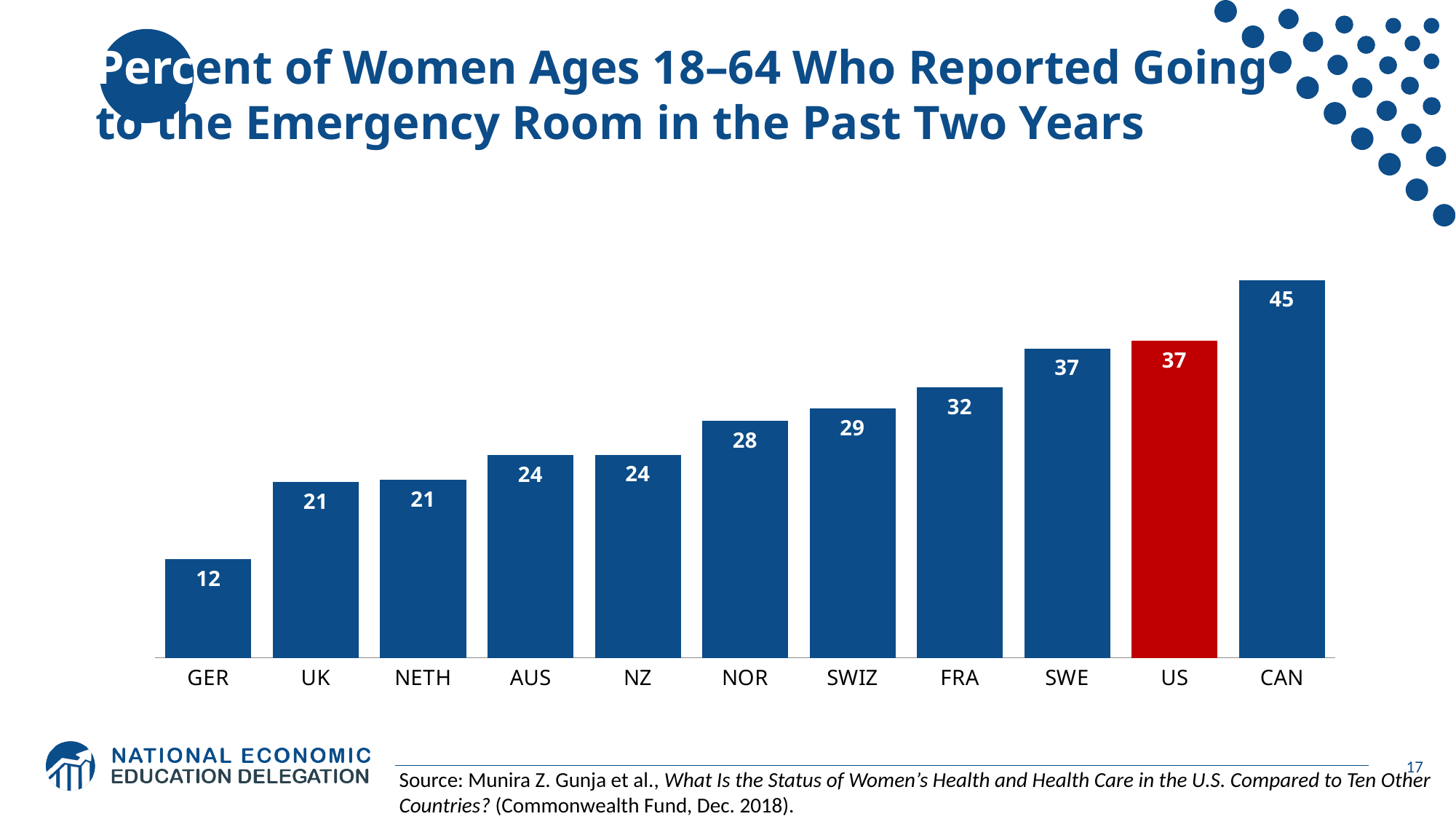
What is the value for NOR? 28 What is the value for the US? 37 What kind of chart is shown on the slide? bar chart How many countries are shown in the chart? 11 What is the difference between the values for FRA and GER? 20 Which is larger, the value for SWIZ or the value for AUS? SWIZ Which country's bar is coloured red? US Do the values rise or fall from left to right across the chart? rise Which country has the highest value? CAN What is the difference between the values for CAN and the US? 8 What is the value for GER? 12 Which country has the lowest value? GER